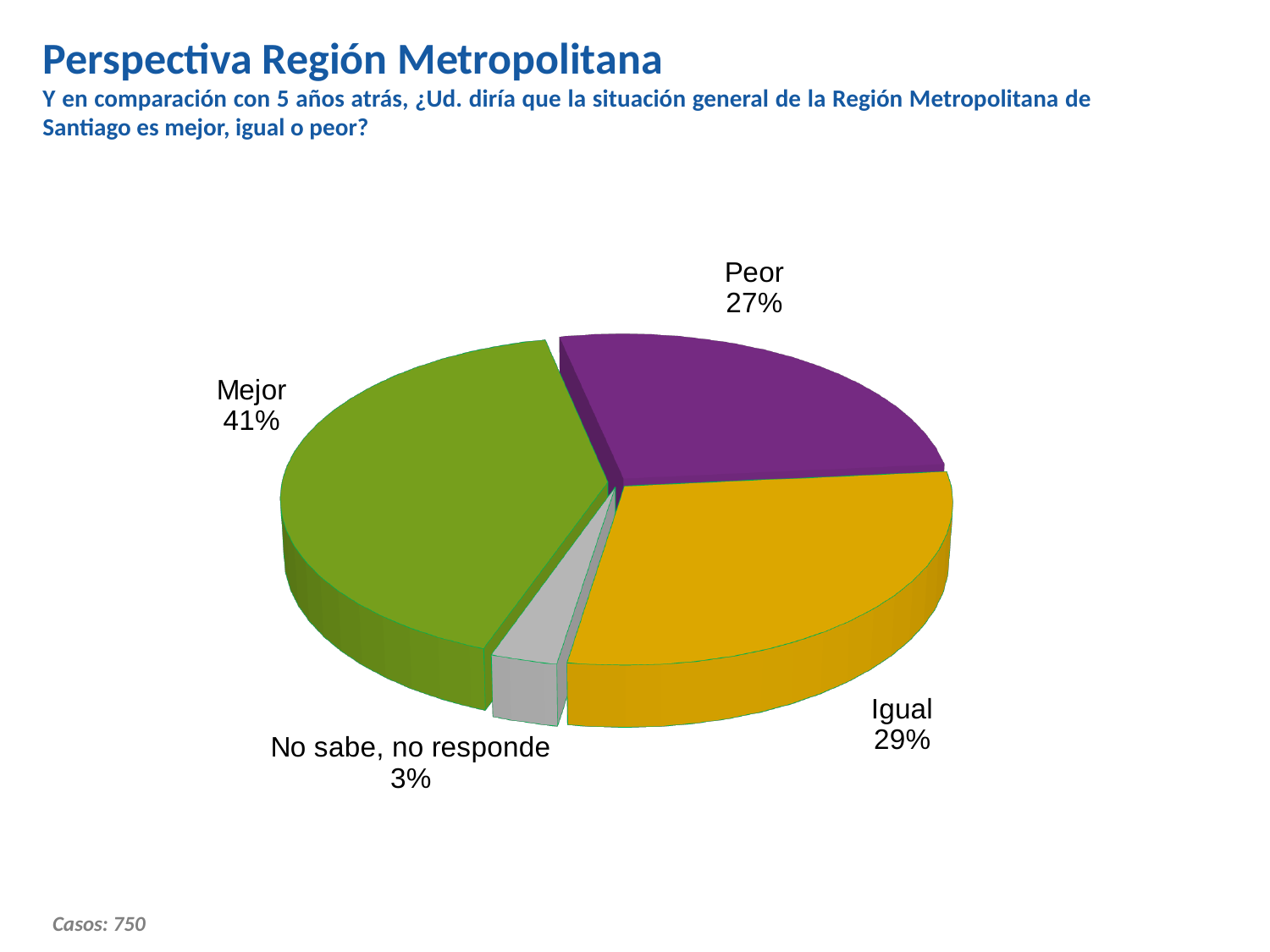
What percentage of respondents answered "Peor"? 27% Which category has the largest share of the pie? Mejor What percentage of respondents answered "No sabe, no responde"? 3% What colour is the "Peor" slice? Purple Which category has the smallest share of the pie? No sabe, no responde What is the difference in percentage points between "Igual" and "Peor"? 2 Which is larger, the share for "Mejor" or the share for "Igual"? Mejor What is the difference in percentage points between "Mejor" and "Peor"? 14 What percentage of respondents answered "Mejor"? 41% What kind of chart is shown on the slide? Pie chart What percentage of respondents answered "Igual"? 29% How many categories are shown in the pie chart? 4